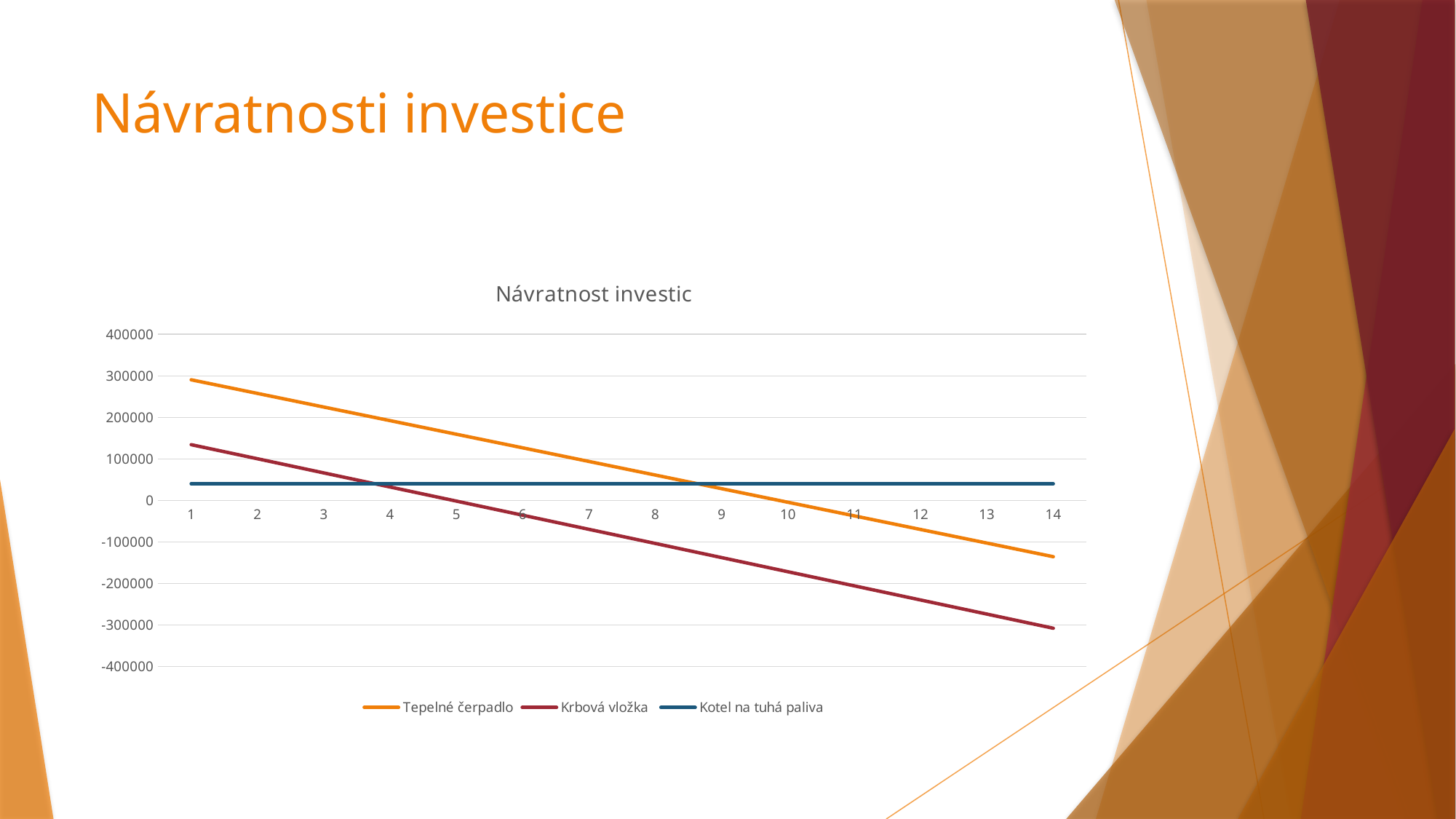
Does the Kotel na tuhá paliva line rise, fall or stay flat along the x axis? stay flat How many points are plotted along the x axis for each series? 14 What kind of chart is shown on the slide? line chart Does the Krbová vložka line rise or fall along the x axis? fall Does the Tepelné čerpadlo line rise or fall from point 1 to point 14? fall How many series does the legend list? 3 Is the value for Krbová vložka at point 14 greater or less than -200000? less Which series has the lowest value at point 14? Krbová vložka Which series has the highest value at point 1? Tepelné čerpadlo What is the title of the chart? Návratnost investic Which colour is used for the Kotel na tuhá paliva series? blue Is the value for Tepelné čerpadlo at point 1 greater or less than 200000? greater